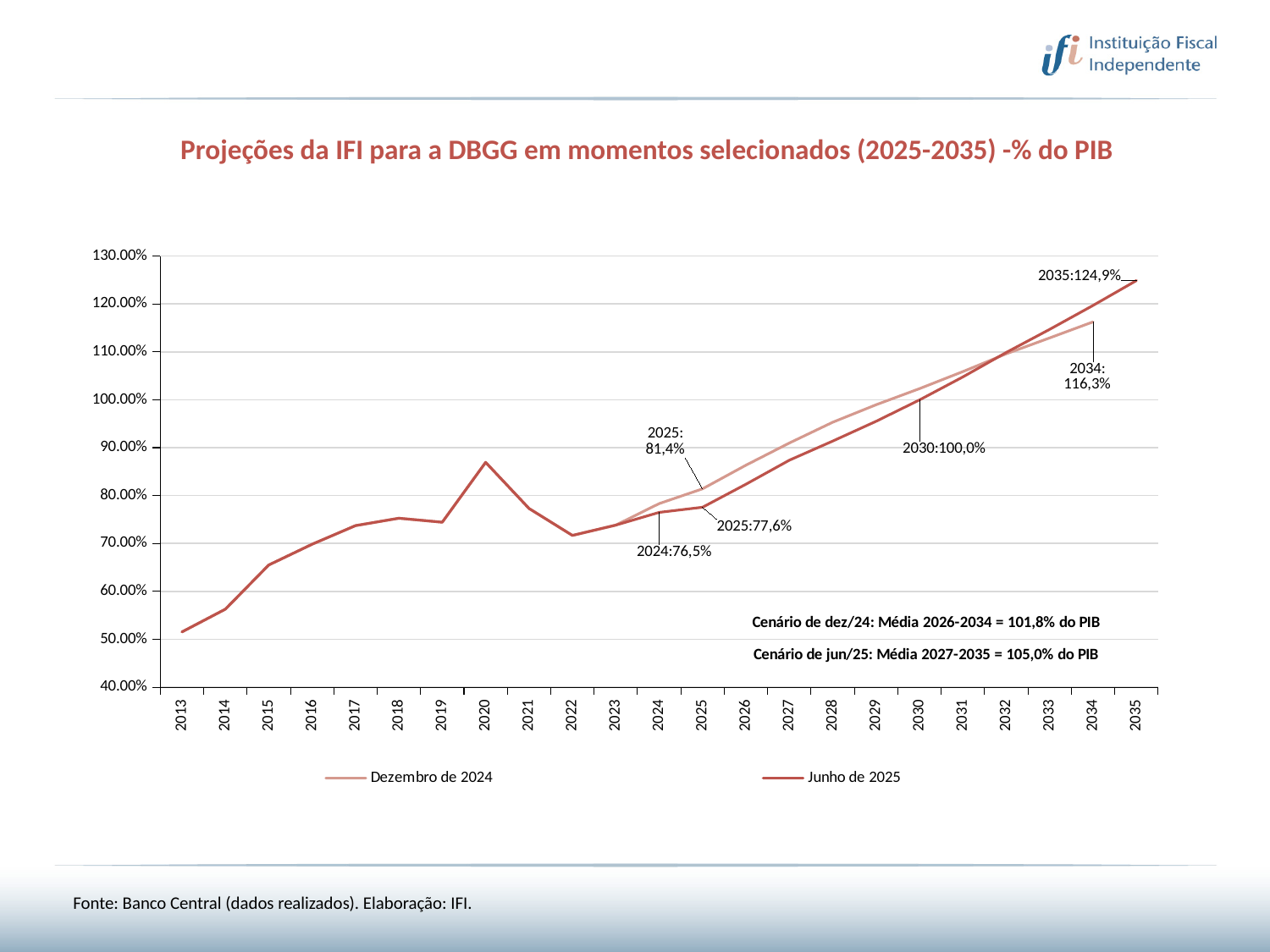
What value is labelled for 2024? 76,5% What is the projected DBGG value for 2035 in the Junho de 2025 series? 124,9% What is the value for 2025 in the Junho de 2025 series? 77,6% What value is labelled for 2030? 100,0% What type of chart is shown on the slide? Line chart How many series does the legend list? 2 What is the value for 2025 in the Dezembro de 2024 series? 81,4% In 2025, which series shows the higher value, Dezembro de 2024 or Junho de 2025? Dezembro de 2024 Is the value for 2020 greater or less than 80%? greater According to the text on the chart, what is the average DBGG for 2027-2035 in the jun/25 scenario? 105,0% do PIB What is the projected DBGG value for 2034 in the Dezembro de 2024 series? 116,3% Is the value for 2013 greater or less than 60%? less